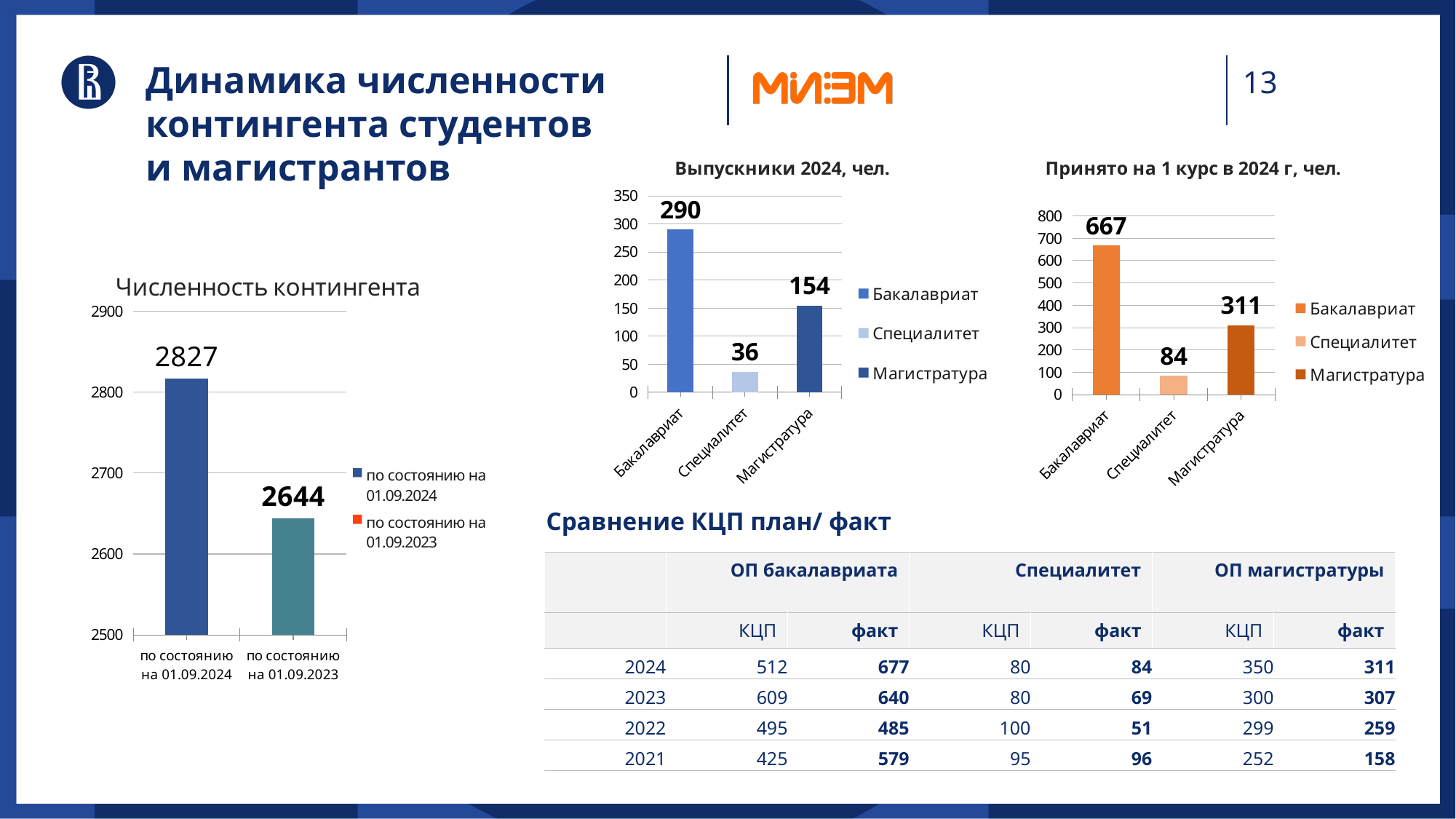
In the chart 'Численность контингента', what is the difference between the values for 01.09.2024 and 01.09.2023? 183 In the chart 'Принято на 1 курс в 2024 г, чел.', how many series does the legend list? 3 In the chart 'Численность контингента', what is the value for 'по состоянию на 01.09.2024'? 2827 In the chart 'Принято на 1 курс в 2024 г, чел.', what is the value for Бакалавриат? 667 What type of chart is 'Численность контингента'? bar chart In the chart 'Принято на 1 курс в 2024 г, чел.', what is the difference between Магистратура and Специалитет? 227 In the chart 'Выпускники 2024, чел.', how many categories are plotted? 3 In the chart 'Выпускники 2024, чел.', what is the value for Магистратура? 154 In the chart 'Выпускники 2024, чел.', what is the difference between Бакалавриат and Магистратура? 136 In the chart 'Численность контингента', which of the two dates has the larger value? по состоянию на 01.09.2024 In the chart 'Принято на 1 курс в 2024 г, чел.', which category has the highest value? Бакалавриат In the chart 'Выпускники 2024, чел.', which category has the lowest value? Специалитет